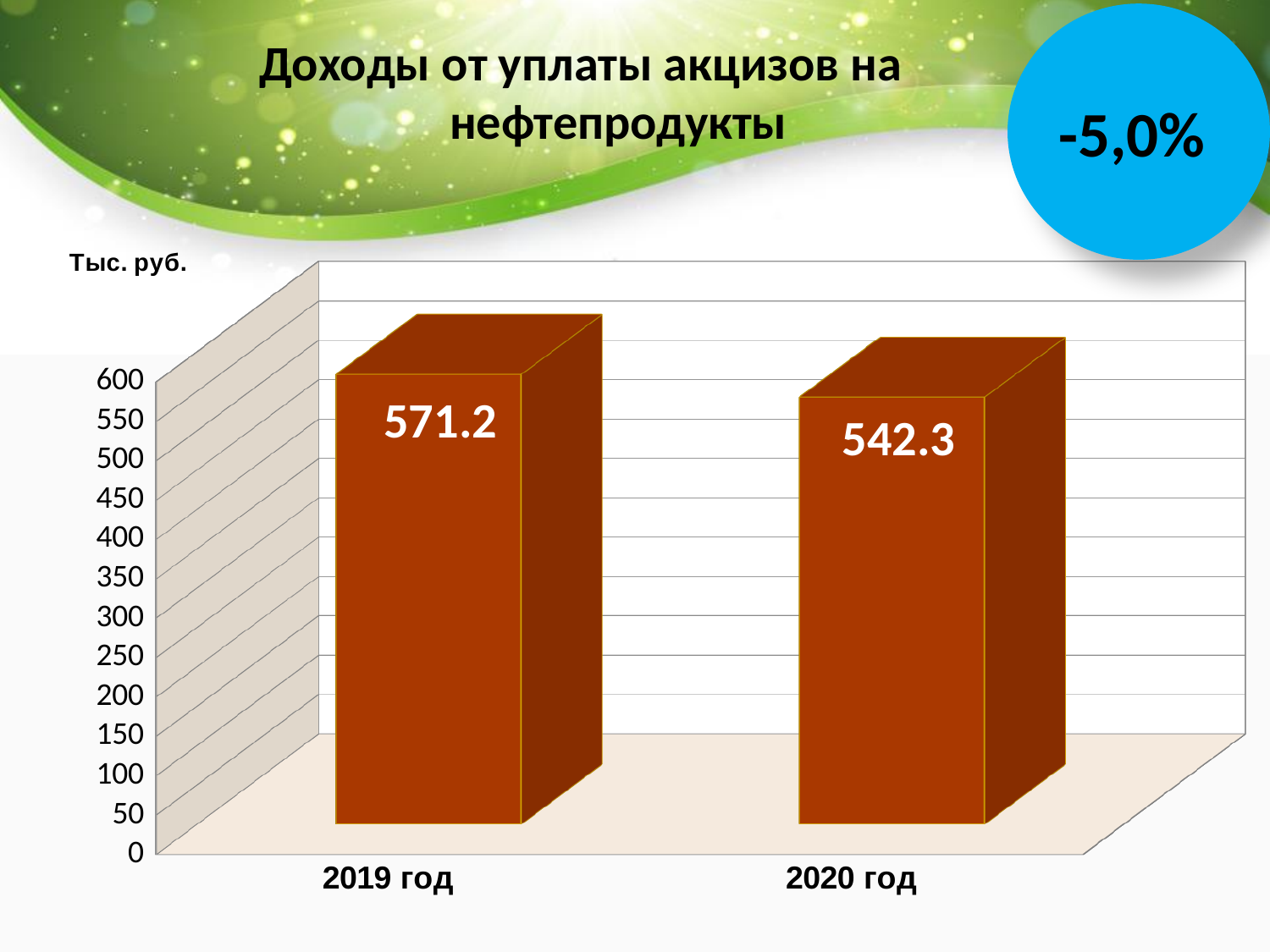
What is the value for 2019 год? 571.2 Do the values rise or fall from 2019 год to 2020 год? fall What kind of chart is shown on the slide? bar chart What is the difference between the values for 2019 год and 2020 год? 28.9 Which year has the highest value? 2019 год Is the value for 2019 год greater or less than 550? greater Which year has the lowest value? 2020 год How many categories are shown on the x axis? 2 What is the value for 2020 год? 542.3 Is the value for 2020 год greater or less than 550? less What unit is indicated above the vertical axis? Тыс. руб. Which is larger, the value for 2019 год or the value for 2020 год? 2019 год